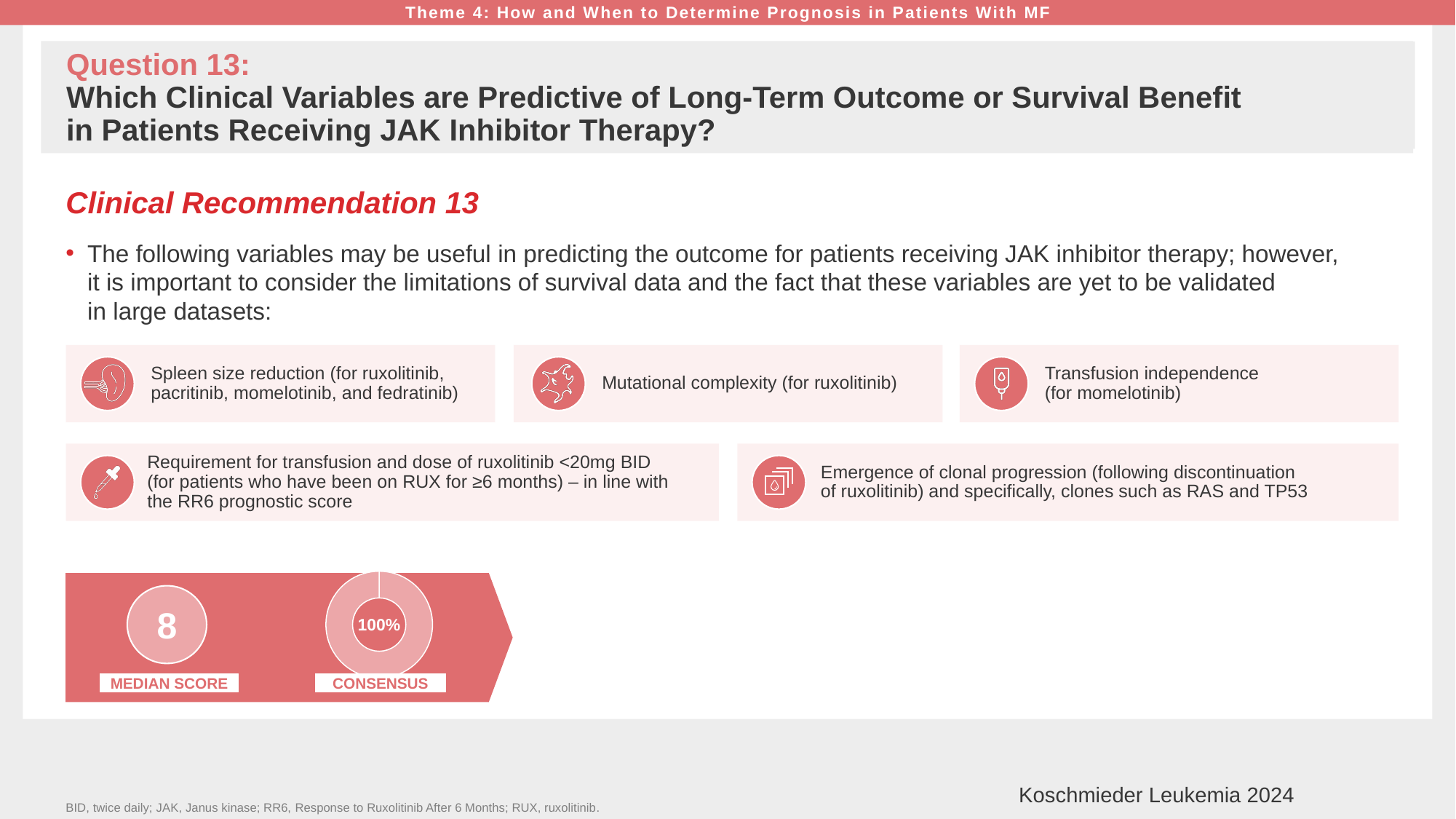
Is the consensus value shown in the donut chart greater or less than 50%? greater What share of the consensus donut chart is filled by the single slice? 100% What median score is shown in the circle next to the consensus donut chart? 8 What kind of chart is used to display the consensus value? pie chart (donut) What label appears beneath the circle showing the number 8? MEDIAN SCORE What label appears beneath the donut chart? CONSENSUS What percentage is shown in the centre of the consensus donut chart? 100%